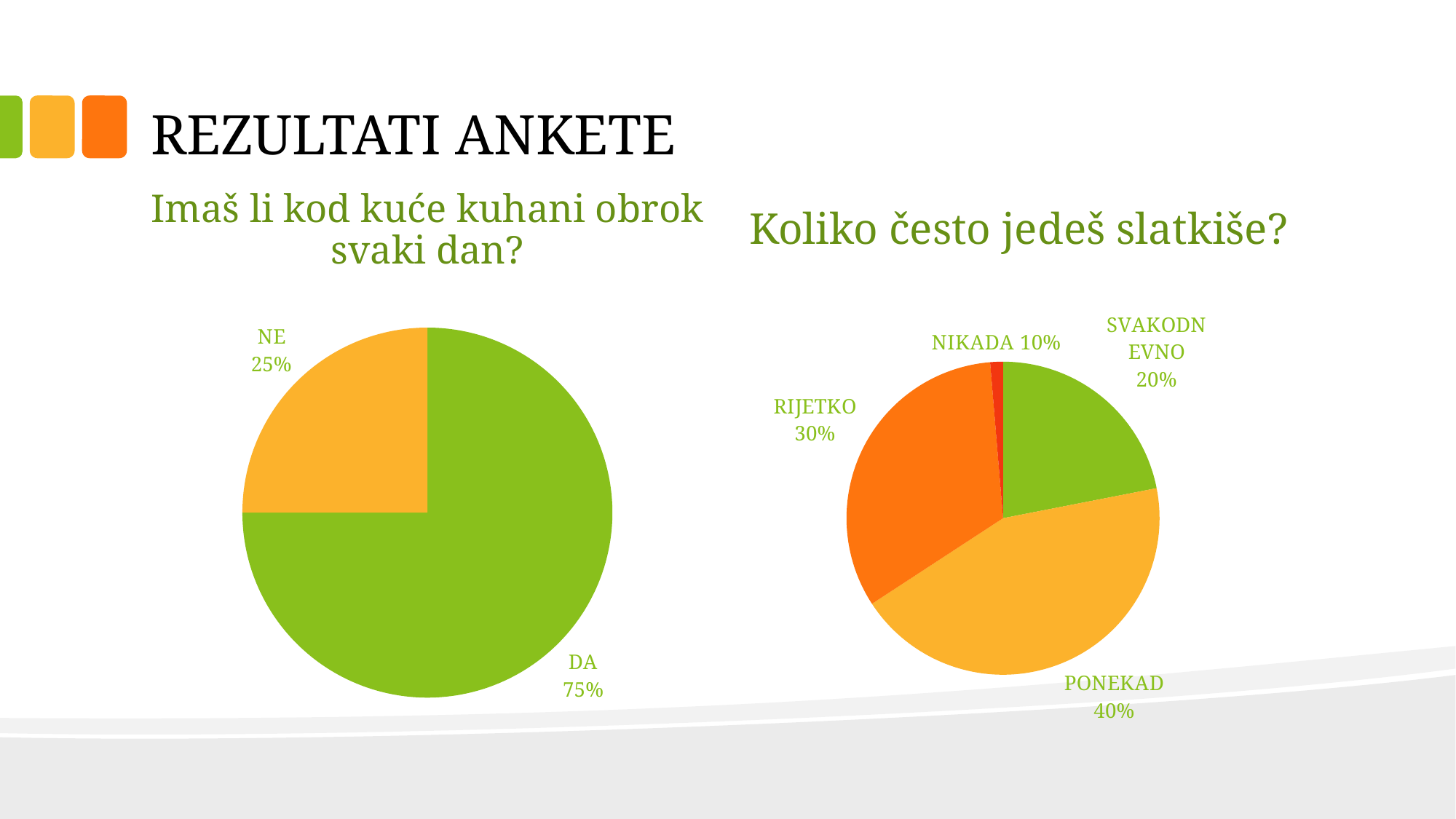
In the left chart 'Imaš li kod kuće kuhani obrok svaki dan?', what is the difference between the DA and NE shares? 50% In the right chart 'Koliko često jedeš slatkiše?', which is larger, SVAKODNEVNO or RIJETKO? RIJETKO In the right chart 'Koliko često jedeš slatkiše?', which slice is the largest? PONEKAD What kind of chart is used for 'Koliko često jedeš slatkiše?'? Pie chart In the right chart 'Koliko često jedeš slatkiše?', how many slices does the pie have? 4 In the left chart 'Imaš li kod kuće kuhani obrok svaki dan?', what share of the pie is DA? 75% In the left chart 'Imaš li kod kuće kuhani obrok svaki dan?', what share of the pie is NE? 25% In the right chart 'Koliko često jedeš slatkiše?', which slice is the smallest? NIKADA In the left chart 'Imaš li kod kuće kuhani obrok svaki dan?', which slice is the largest? DA In the right chart 'Koliko često jedeš slatkiše?', what share of the pie is RIJETKO? 30% In the left chart 'Imaš li kod kuće kuhani obrok svaki dan?', how many slices does the pie have? 2